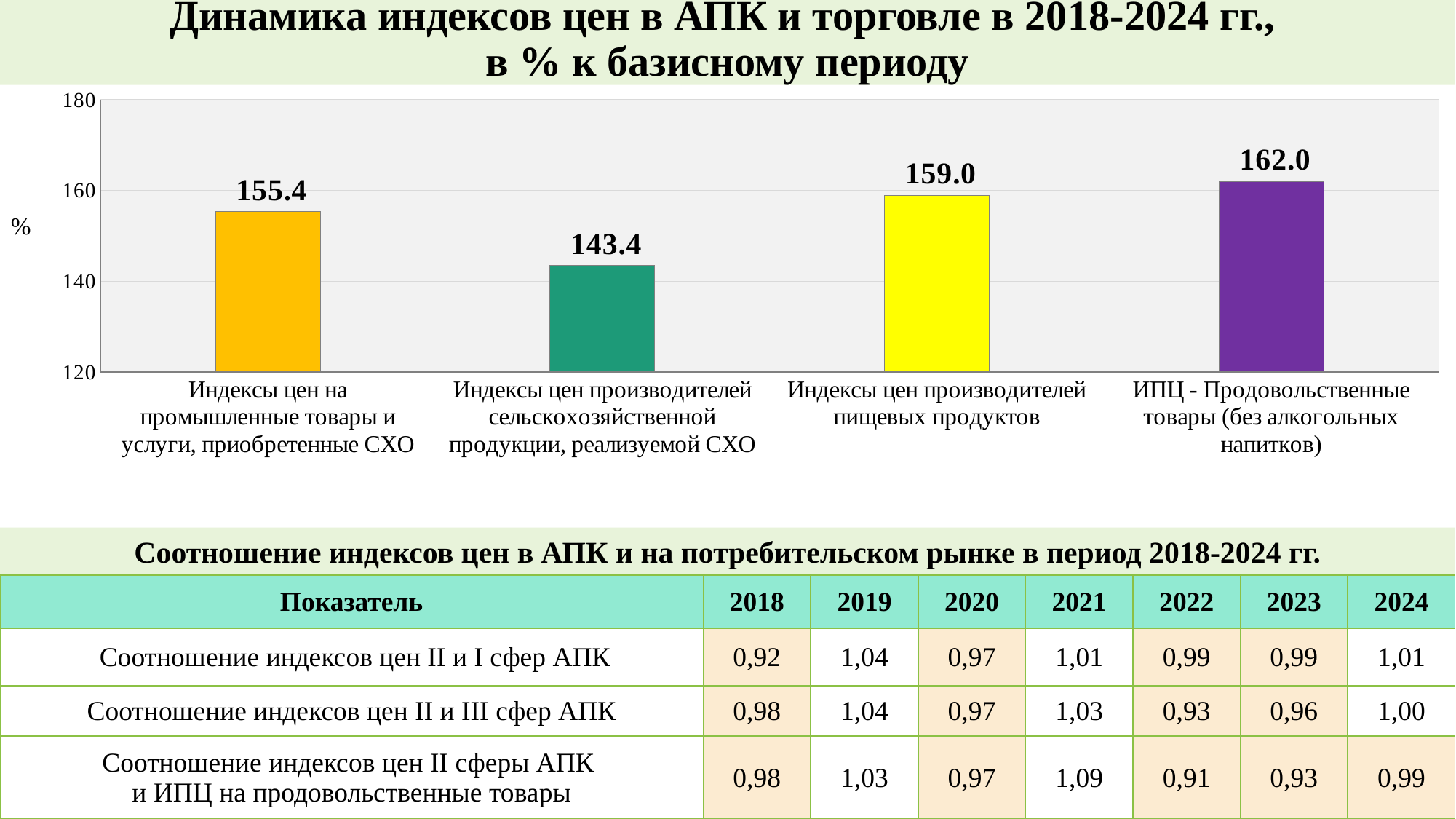
What is the value for 'Индексы цен на промышленные товары и услуги, приобретенные СХО'? 155.4 What is the difference between the value for 'ИПЦ - Продовольственные товары (без алкогольных напитков)' and the value for 'Индексы цен производителей сельскохозяйственной продукции, реализуемой СХО'? 18.6 What is the title of the chart? Динамика индексов цен в АПК и торговле в 2018-2024 гг., в % к базисному периоду What is the value for 'ИПЦ - Продовольственные товары (без алкогольных напитков)'? 162.0 Is the value for 'Индексы цен производителей сельскохозяйственной продукции, реализуемой СХО' greater or less than 160? less How many categories are shown in the chart? 4 What is the value for 'Индексы цен производителей пищевых продуктов'? 159.0 What kind of chart is shown on the slide? bar chart What is the value for 'Индексы цен производителей сельскохозяйственной продукции, реализуемой СХО'? 143.4 Which is larger: the value for 'Индексы цен на промышленные товары и услуги, приобретенные СХО' or the value for 'Индексы цен производителей пищевых продуктов'? Индексы цен производителей пищевых продуктов Which category has the lowest value? Индексы цен производителей сельскохозяйственной продукции, реализуемой СХО Which category has the highest value? ИПЦ - Продовольственные товары (без алкогольных напитков)